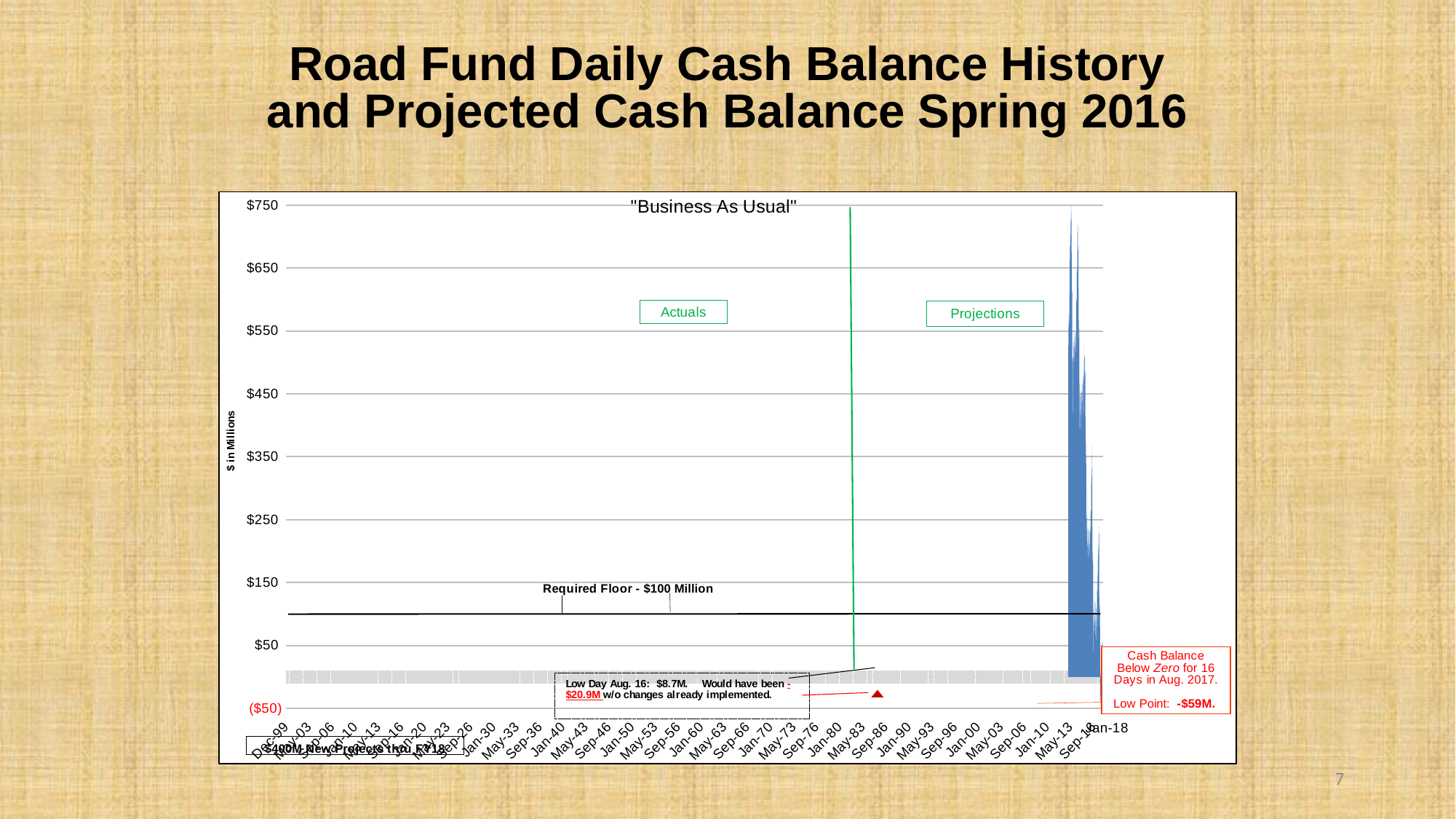
According to the chart annotation, what was the cash balance on the Low Day, Aug. 16? $8.7M What is the projected low point of the cash balance stated in the red box on the chart? -$59M Which is larger: the Low Day Aug. 16 balance of $8.7M or the projected low point of -$59M? $8.7M For how many days in Aug. 2017 does the chart say the cash balance is projected to be below zero? 16 What is the label on the vertical axis of the chart? $ in Millions According to the chart annotation, what would the Aug. 16 low day balance have been without the changes already implemented? -$20.9M What value does the chart annotate as the Required Floor? $100 Million What is the highest value shown on the vertical axis of the chart? $750 What is the title shown at the top of the chart? "Business As Usual" Is the Required Floor of $100 Million greater or less than the $150 gridline on the vertical axis? less